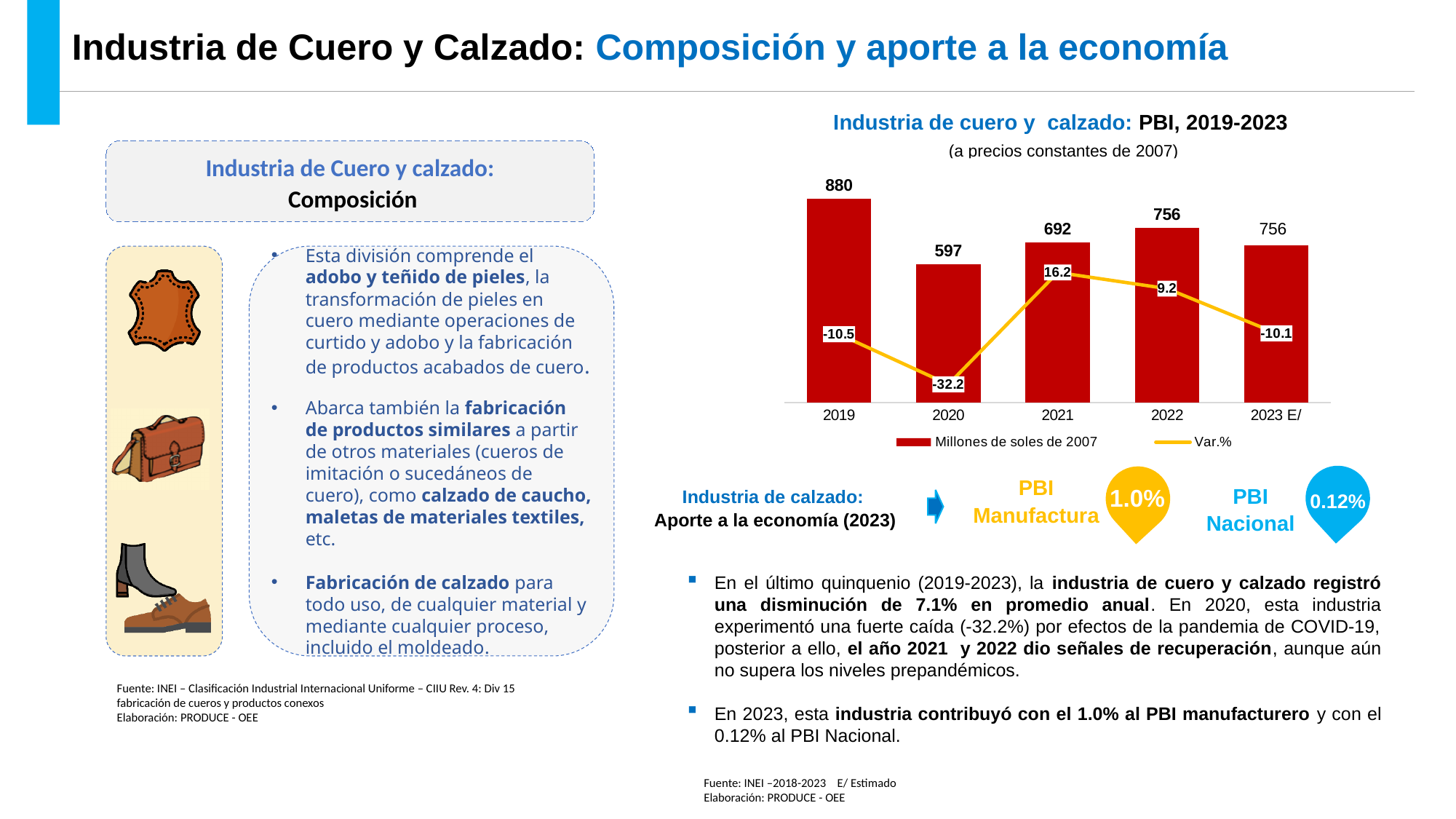
What kind of chart is used to show the 'Millones de soles de 2007' series? Bar chart What is the difference between the 'Millones de soles de 2007' values for 2019 and 2020? 283 Which is larger, the 'Millones de soles de 2007' value for 2021 or for 2022? 2022 Which year has the lowest 'Millones de soles de 2007' bar? 2020 Which year has the lowest Var.% value? 2020 How many series does the chart legend list? 2 Which year has the highest 'Millones de soles de 2007' bar? 2019 What is the Var.% value for 2020? -32.2 What is the value of the 'Millones de soles de 2007' bar for 2020? 597 What is the value of the 'Millones de soles de 2007' bar for 2019? 880 How many years are shown on the x axis of the chart? 5 What is the Var.% value for 2021? 16.2